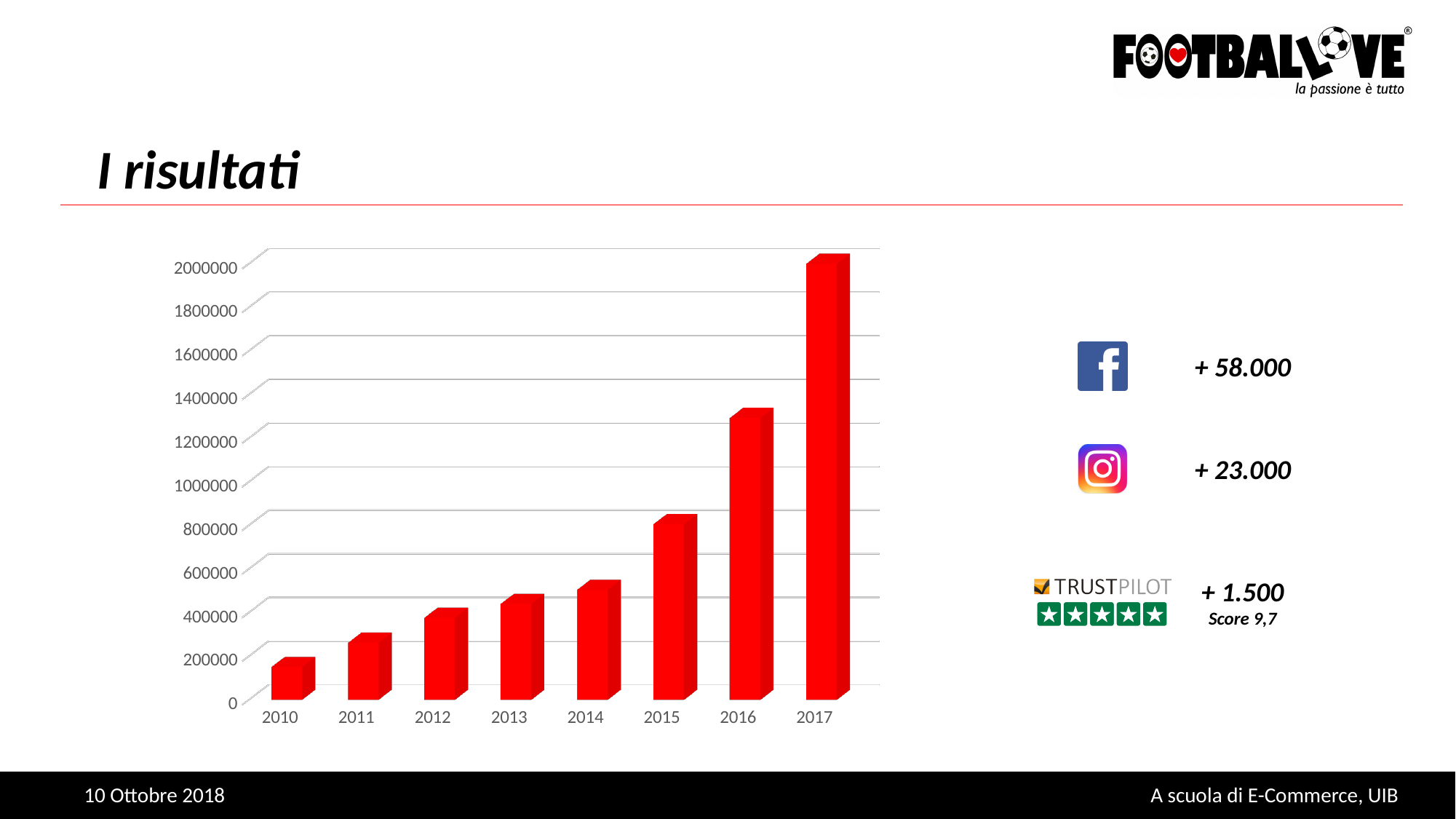
Is the value for 2016 greater or less than 1000000? greater Which year has the lowest bar in the chart? 2010 Which year has the highest bar in the chart? 2017 Is the value for 2014 greater or less than 600000? less Is the value for 2017 greater or less than 1800000? greater What colour are the bars in the chart? red What kind of chart is shown on the slide? bar chart Do the values rise or fall from 2010 to 2017? rise Which is larger, the value for 2016 or the value for 2015? 2016 How many years are shown on the x axis of the chart? 8